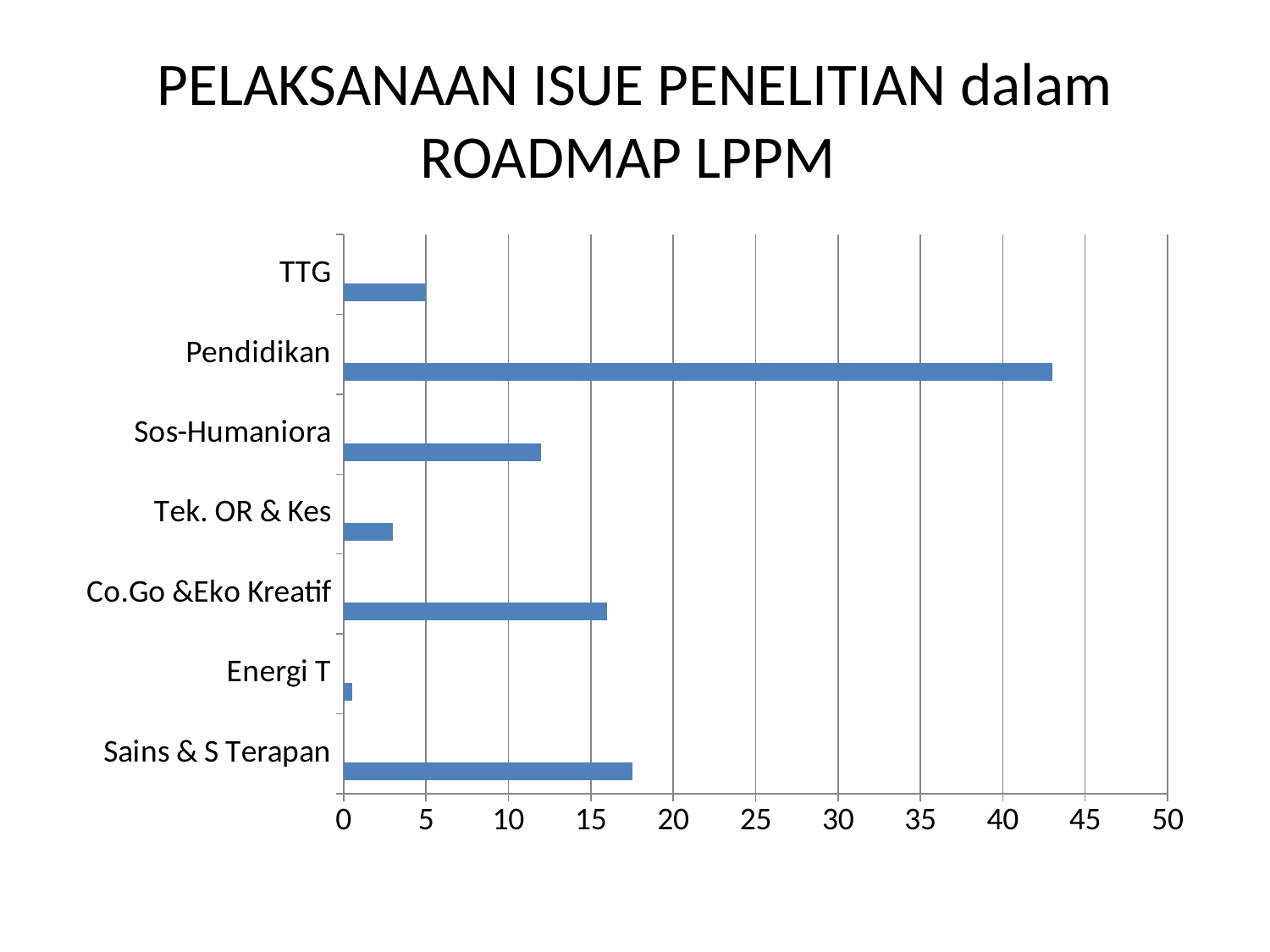
How many categories are plotted in the chart? 7 Is the value for Sains & S Terapan greater or less than 20? less What is the value for TTG? 5 Is the value for Tek. OR & Kes greater or less than 5? less Is the value for Sos-Humaniora greater or less than 10? greater What is the title of the chart on the slide? PELAKSANAAN ISUE PENELITIAN dalam ROADMAP LPPM Which category has the highest value? Pendidikan Which category has the lowest value? Energi T What kind of chart is shown on the slide? bar chart Which is larger, the value for Sos-Humaniora or the value for Co.Go &Eko Kreatif? Co.Go &Eko Kreatif